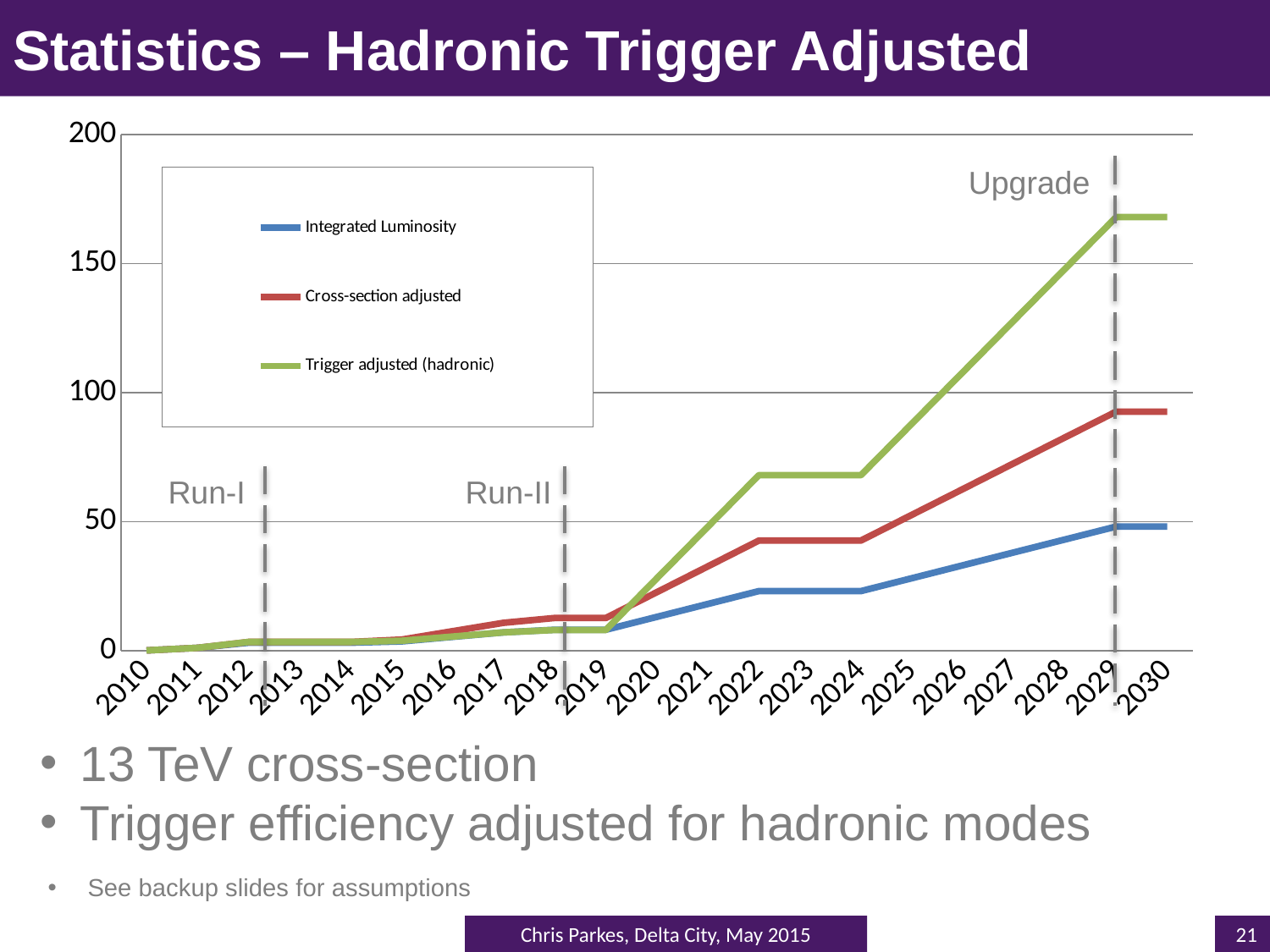
Is the value of Cross-section adjusted in 2030 greater or less than 100? less Which series has the highest value in 2030? Trigger adjusted (hadronic) In 2025, which is larger: Cross-section adjusted or Integrated Luminosity? Cross-section adjusted How many years are shown along the x axis? 21 Is the value of Trigger adjusted (hadronic) in 2030 greater or less than 150? greater What is the title of the slide containing the chart? Statistics – Hadronic Trigger Adjusted Do the values of Trigger adjusted (hadronic) generally rise or fall from 2010 to 2030? rise Which series has the lowest value in 2030? Integrated Luminosity How many series does the legend list? 3 What kind of chart is shown on the slide? line chart Is the value of Trigger adjusted (hadronic) in 2022 greater or less than 50? greater